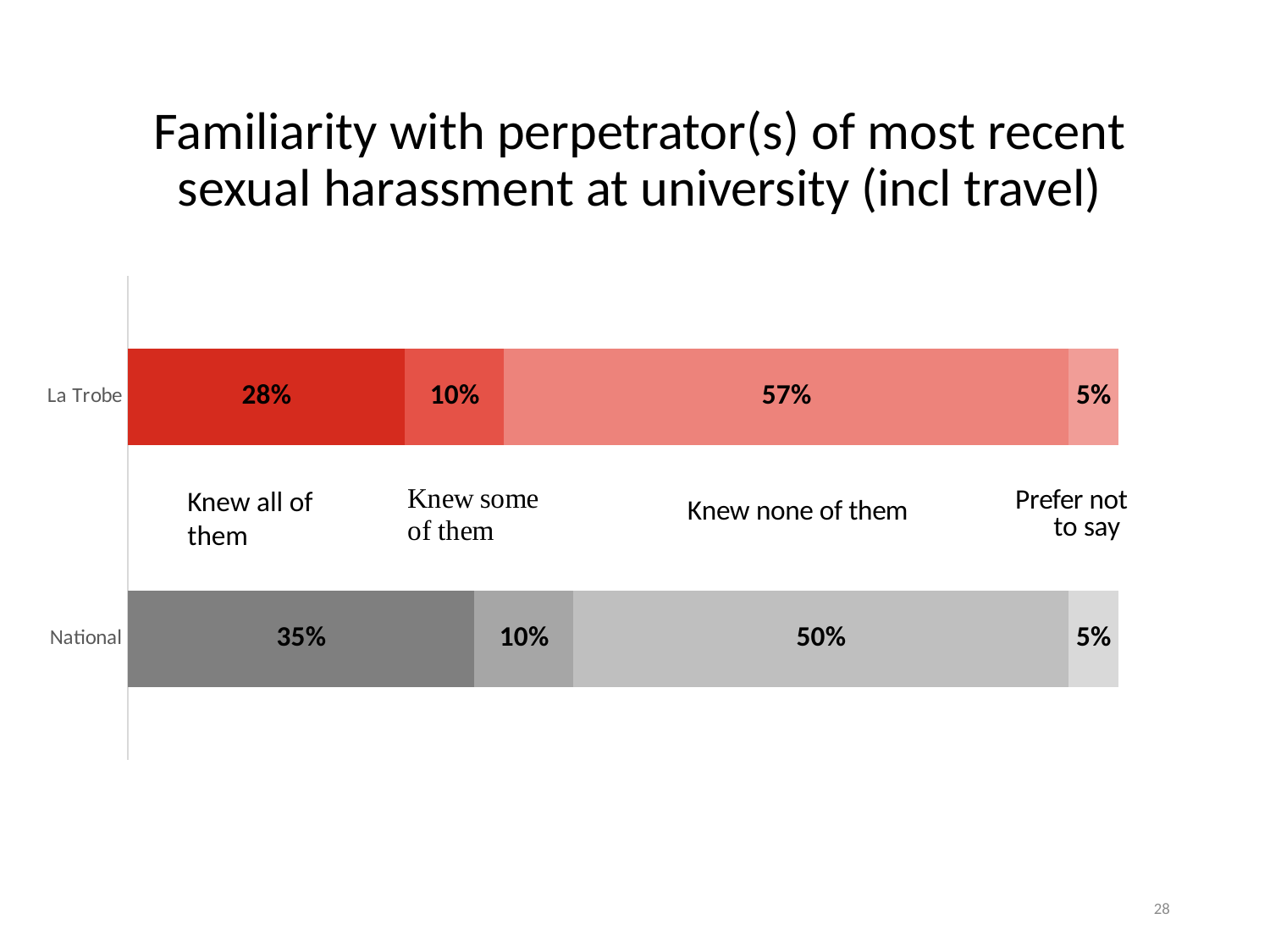
Which response category has the highest share for La Trobe? Knew none of them Which is larger: the 'Knew all of them' share for La Trobe or for National? National What is the difference between the National and La Trobe percentages for 'Knew all of them'? 7% How many response categories are shown in each bar? 4 What type of chart is shown on the slide? Stacked bar chart What percentage of National respondents preferred not to say? 5% How many bars (groups) are shown in the chart? 2 What percentage of La Trobe respondents knew some of the perpetrators? 10% What percentage of National respondents knew none of the perpetrators? 50% What is the difference between the La Trobe and National percentages for 'Knew none of them'? 7% Which response category has the lowest share for National? Prefer not to say What percentage of La Trobe respondents knew all of the perpetrators? 28%